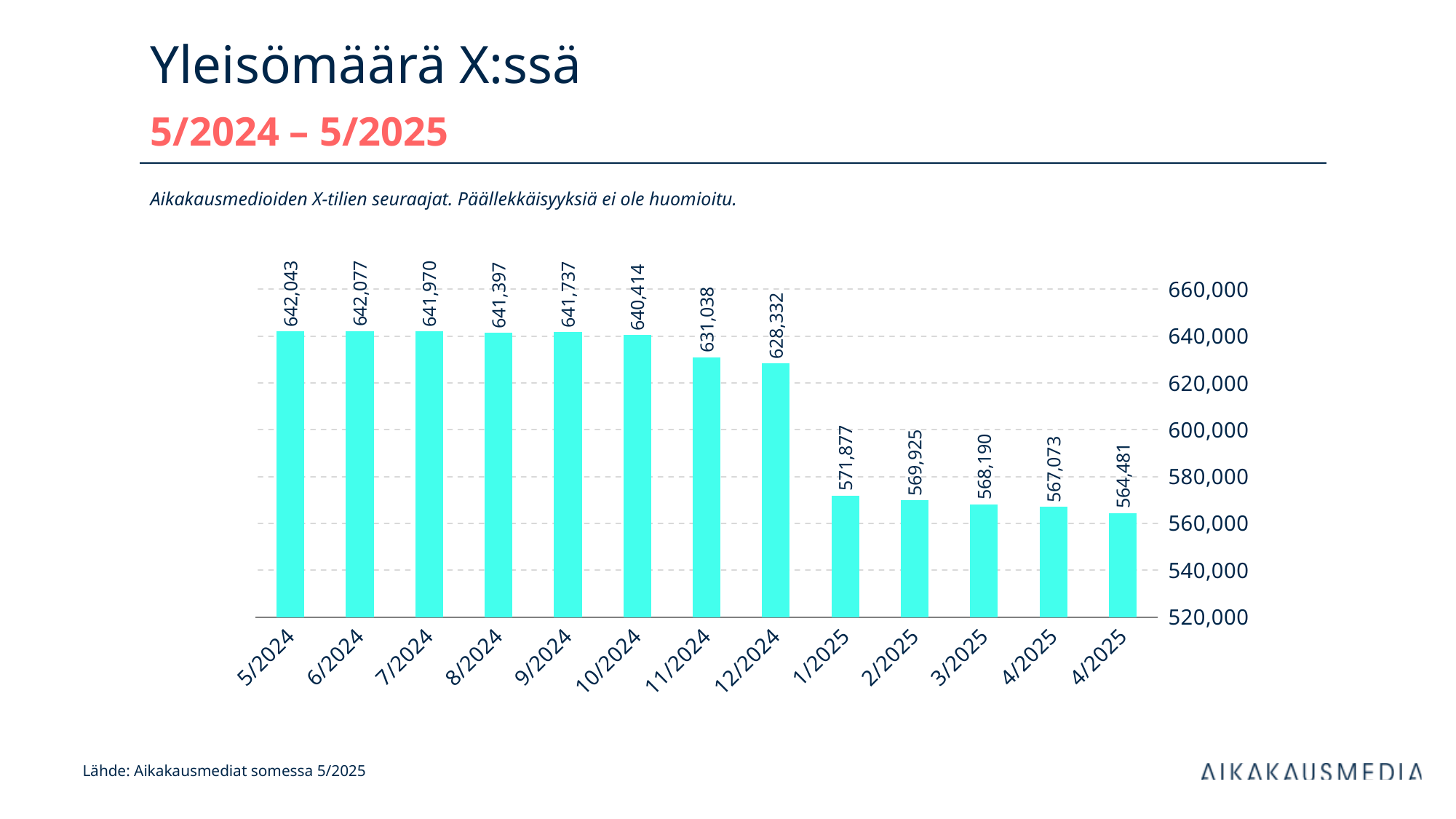
Which month has the highest value according to the data labels? 6/2024 What is the difference between the values for 5/2024 and 1/2025? 70,166 What is the value for 5/2024? 642,043 How many bars are shown in the chart? 13 Which is larger, the value for 10/2024 or the value for 11/2024? 10/2024 What is the value of the last (rightmost) bar? 564,481 What is the value for 12/2024? 628,332 What is the difference between the values for 11/2024 and 12/2024? 2,706 What is the value for 1/2025? 571,877 Is the value for 1/2025 greater or less than 580,000? less What kind of chart is shown on the slide? bar chart Do the values generally rise or fall from left to right along the x axis? fall